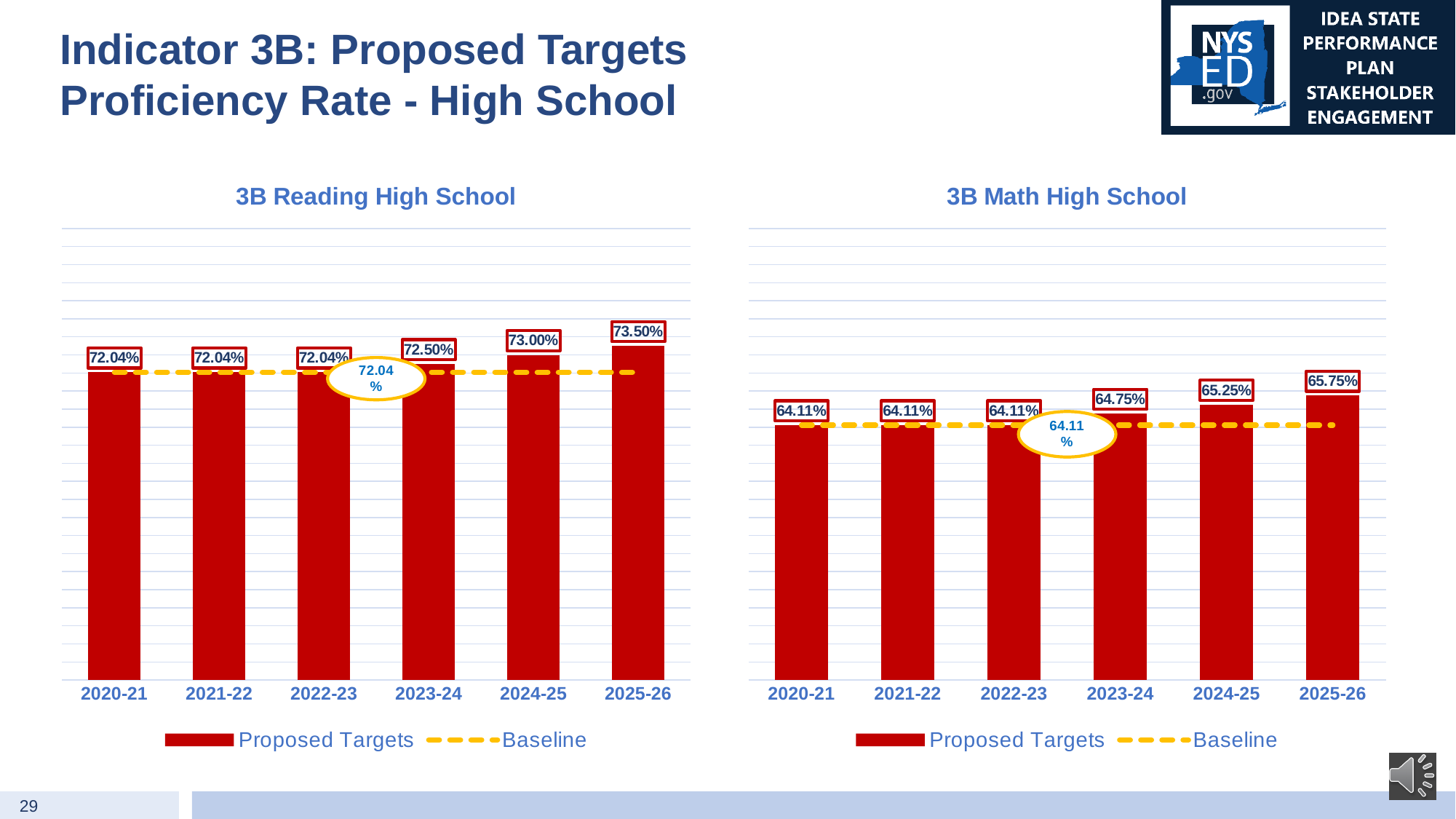
In the 3B Math High School chart, what is the difference between the proposed targets for 2024-25 and 2023-24? 0.50% In the 3B Math High School chart, which year has the highest proposed target? 2025-26 In the 3B Reading High School chart, do the proposed targets rise or fall from 2022-23 to 2025-26? Rise How many years are shown on the x axis of the 3B Reading High School chart? 6 In the 3B Reading High School chart, what is the difference between the proposed targets for 2025-26 and 2020-21? 1.46% In the 3B Math High School chart, what is the proposed target for 2023-24? 64.75% In the 3B Math High School chart, what is the baseline value shown on the dashed line? 64.11% In the 3B Reading High School chart, what is the proposed target for 2025-26? 73.50% In the 3B Reading High School chart, which is larger, the proposed target for 2024-25 or for 2023-24? 2024-25 How many series does the legend of the 3B Math High School chart list? 2 What kind of chart is the 3B Math High School chart? Combination bar and line chart In the 3B Reading High School chart, what is the baseline value shown on the dashed line? 72.04%